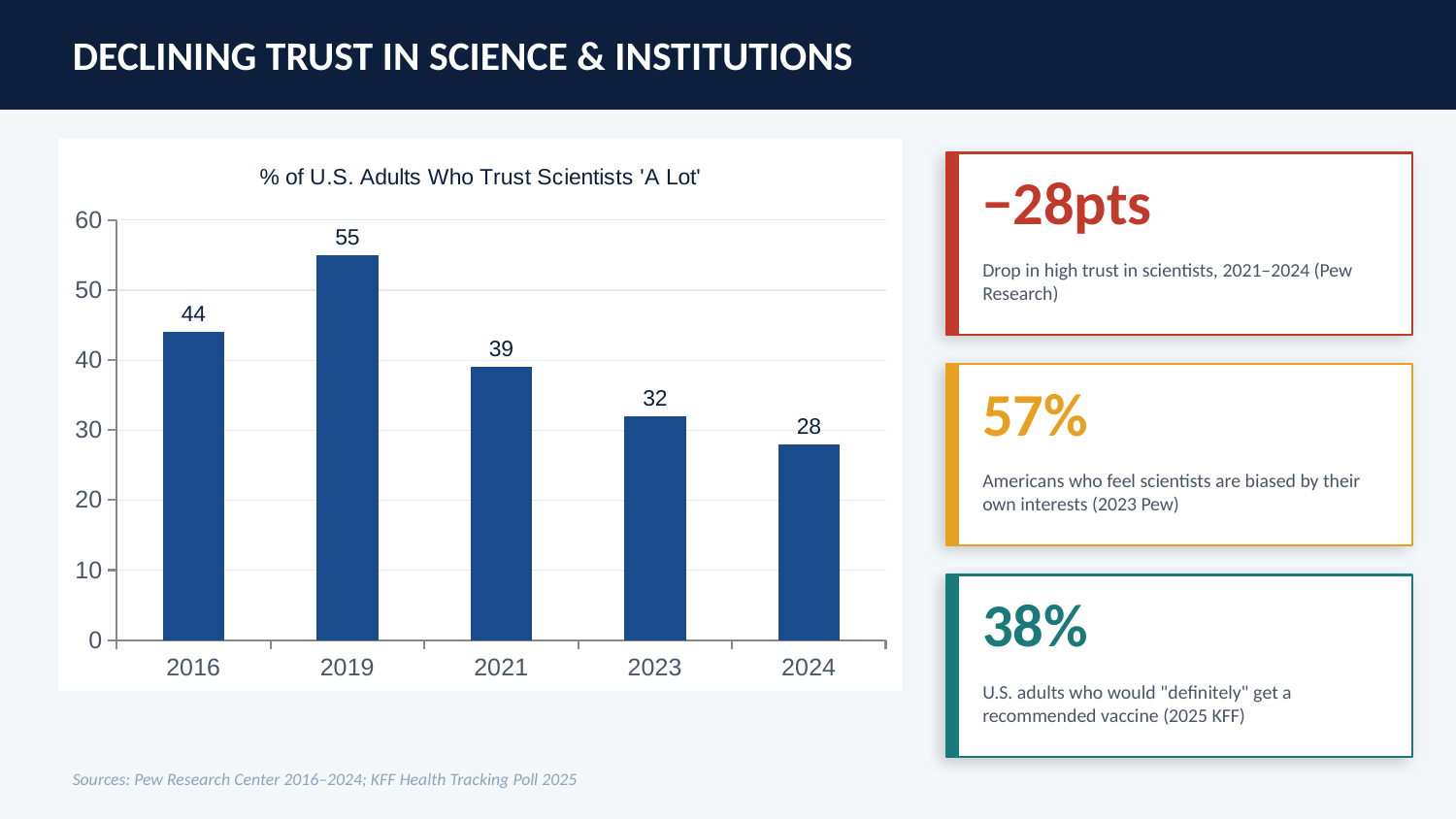
Which year has the lowest value in the chart? 2024 Which year has the highest value in the chart? 2019 What is the title of the chart? % of U.S. Adults Who Trust Scientists 'A Lot' What kind of chart is shown on the slide? bar chart Which is larger, the value for 2016 or the value for 2021? 2016 What is the value for 2024 in the chart? 28 What is the difference between the values for 2021 and 2023? 7 What is the difference between the values for 2019 and 2024? 27 Is the value for 2023 greater or less than 40? less What is the value for 2016 in the chart? 44 What is the value for 2021 in the chart? 39 How many years are shown on the x axis of the chart? 5